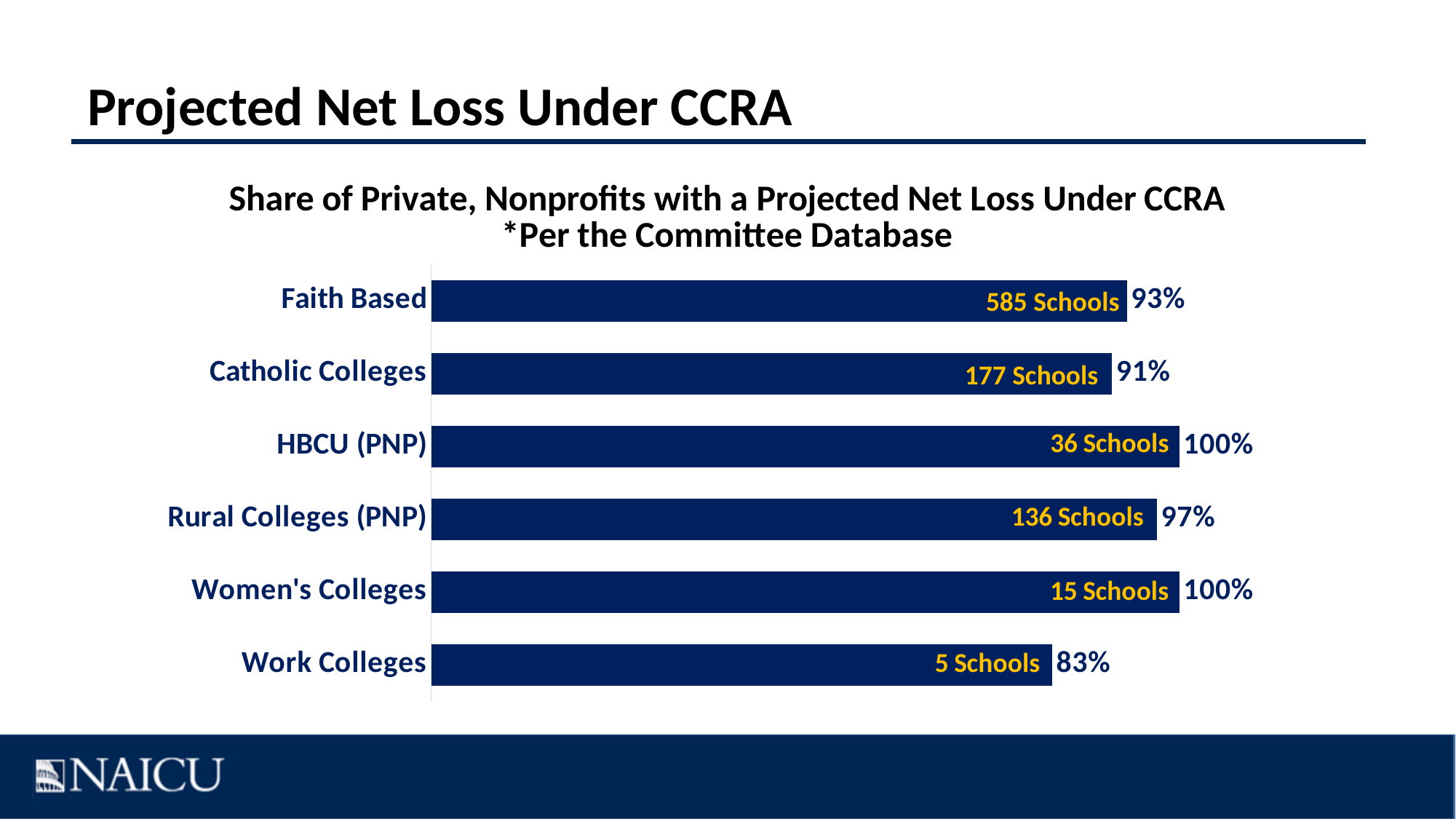
Which has a higher percentage, Faith Based or Work Colleges? Faith Based What kind of chart is shown? Bar chart How many categories are shown in the chart? 6 Which category has the lowest percentage? Work Colleges What percentage is shown for Work Colleges? 83% How many schools are labeled on the Rural Colleges (PNP) bar? 136 Schools What is the title of the chart? Share of Private, Nonprofits with a Projected Net Loss Under CCRA *Per the Committee Database What is the difference in the number of schools between Faith Based and Catholic Colleges? 408 What percentage is shown for Faith Based? 93% How many schools are labeled on the Catholic Colleges bar? 177 Schools Which categories show 100%? HBCU (PNP) and Women's Colleges What is the difference in percentage between Rural Colleges (PNP) and Catholic Colleges? 6%